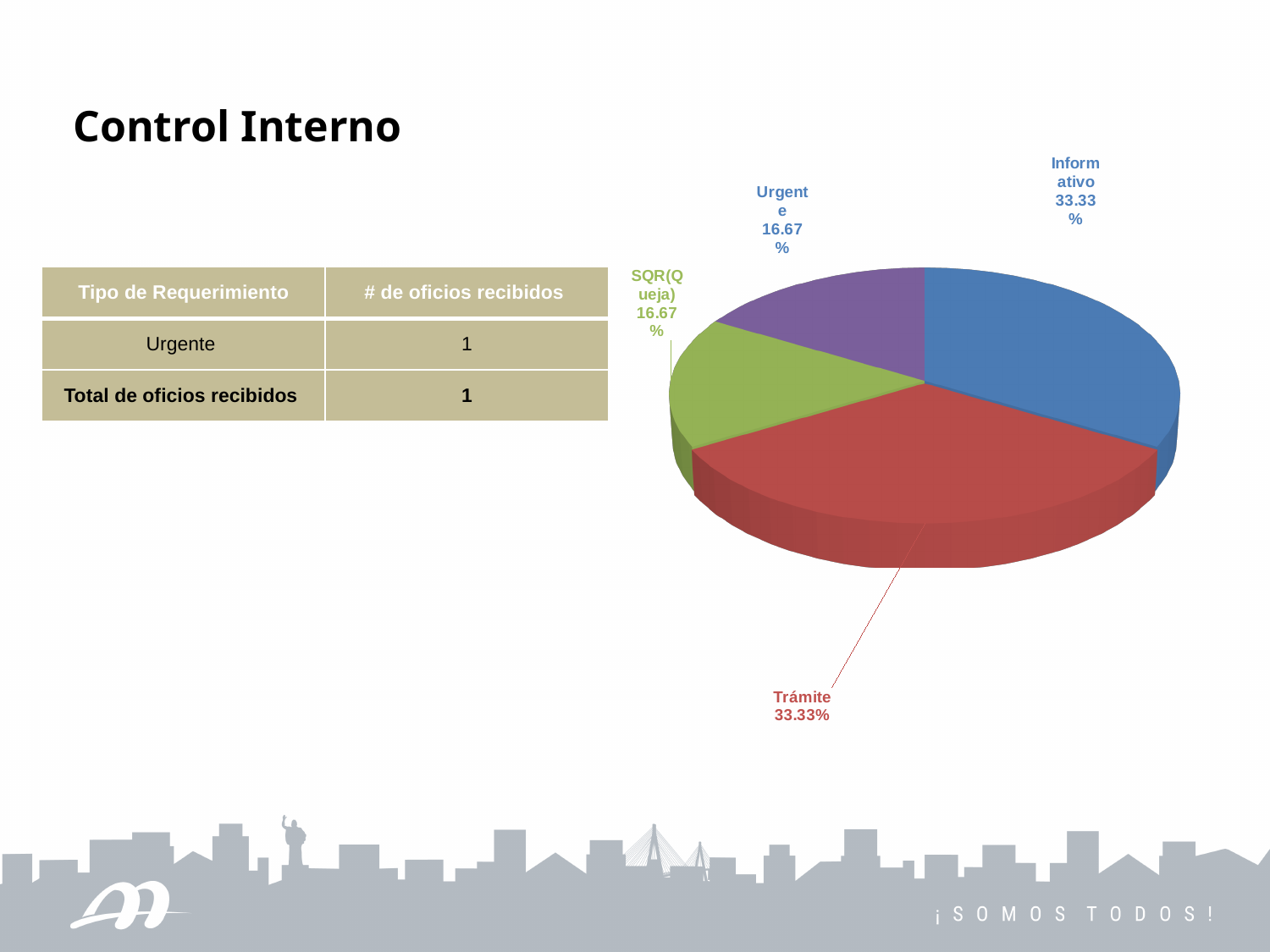
What kind of chart is shown on the slide? Pie chart How many slices does the pie chart have? 4 What share of the pie does Urgente represent? 16.67% What share of the pie does Informativo represent? 33.33% Is the share for Informativo greater or less than 25%? greater What share of the pie does Trámite represent? 33.33% What colour is the Urgente slice of the pie chart? Purple What colour is the Trámite slice of the pie chart? Red Which is larger in the pie chart, Trámite or SQR(Queja)? Trámite What is the difference in percentage points between the Trámite slice and the Urgente slice? 16.66% Which is larger in the pie chart, Informativo or Urgente? Informativo